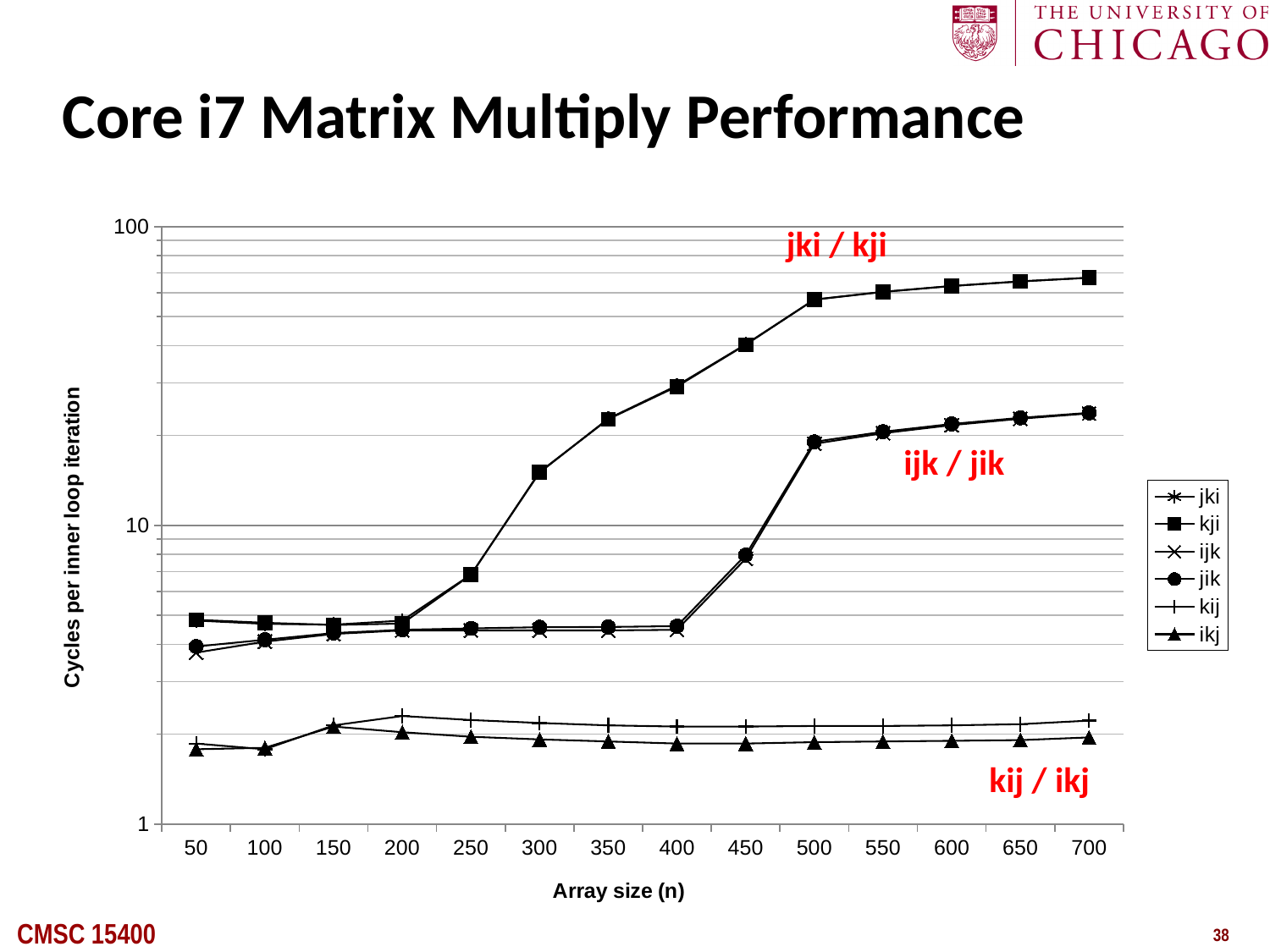
Which labelled group of series has the highest values at array size 700? jki / kji How many array size values are plotted along the x axis? 14 Is the value for jik at array size 500 greater or less than 10? greater Do the values for kji rise or fall as array size increases from 50 to 700? rise How many series does the legend list? 6 Is the value for kij at array size 700 greater or less than 10? less What kind of chart is shown on the slide? line chart At array size 300, which is larger: the value for kji or the value for ikj? kji At array size 700, which is larger: the value for kji or the value for jik? kji Is the value for kji at array size 700 greater or less than 10? greater What is the label on the y axis? Cycles per inner loop iteration